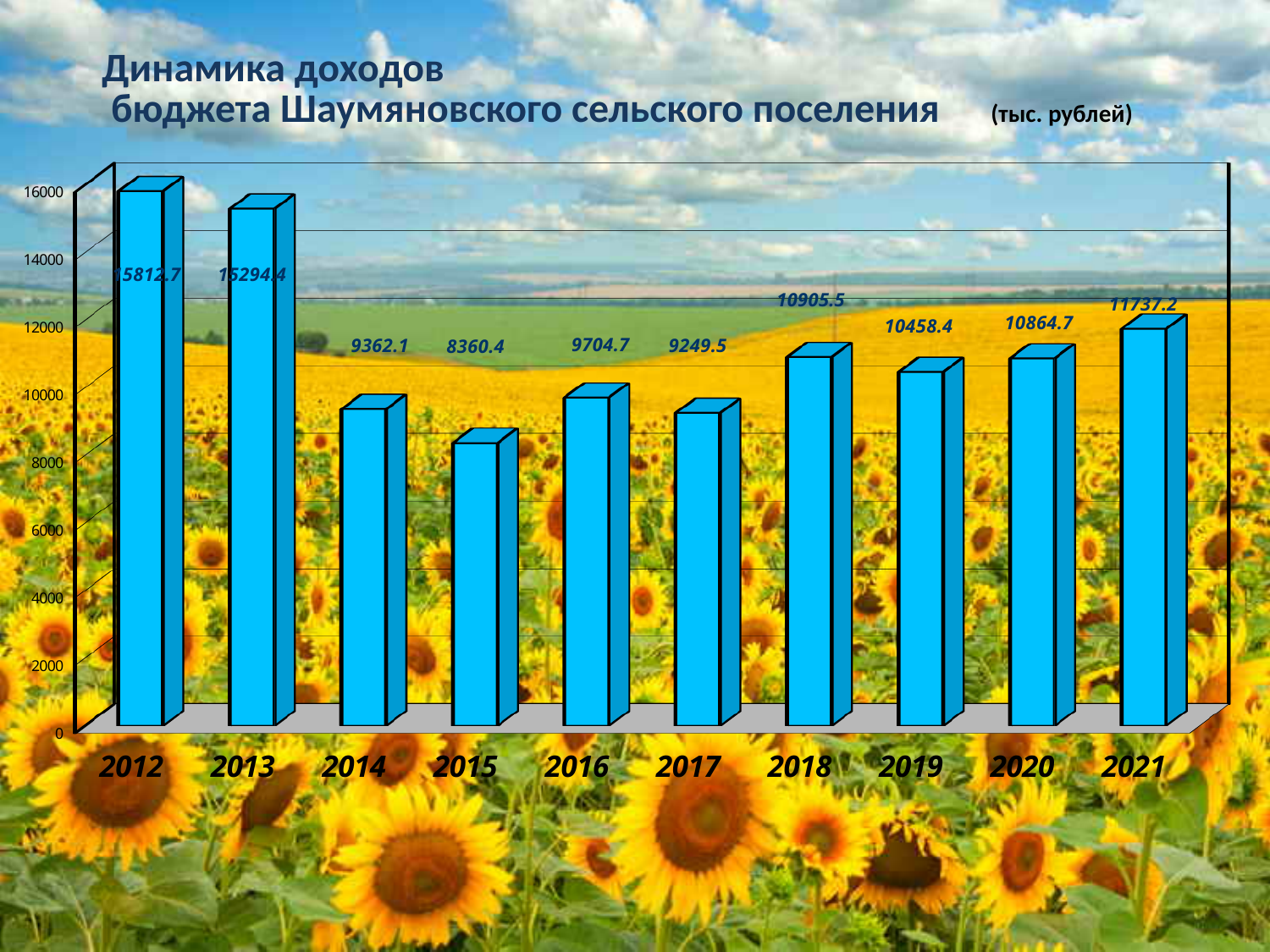
Is the value for 2013 greater or less than 14000? greater How many years are shown on the x axis? 10 Which year has the lowest value? 2015 What is the value for 2021? 11737.2 What kind of chart is shown on the slide? bar chart Which year has the highest value? 2012 What is the difference between the values for 2018 and 2019? 447.1 What is the value for 2018? 10905.5 What is the value for 2015? 8360.4 What is the value for 2014? 9362.1 What is the difference between the values for 2021 and 2020? 872.5 Which is larger, the value for 2016 or the value for 2017? 2016